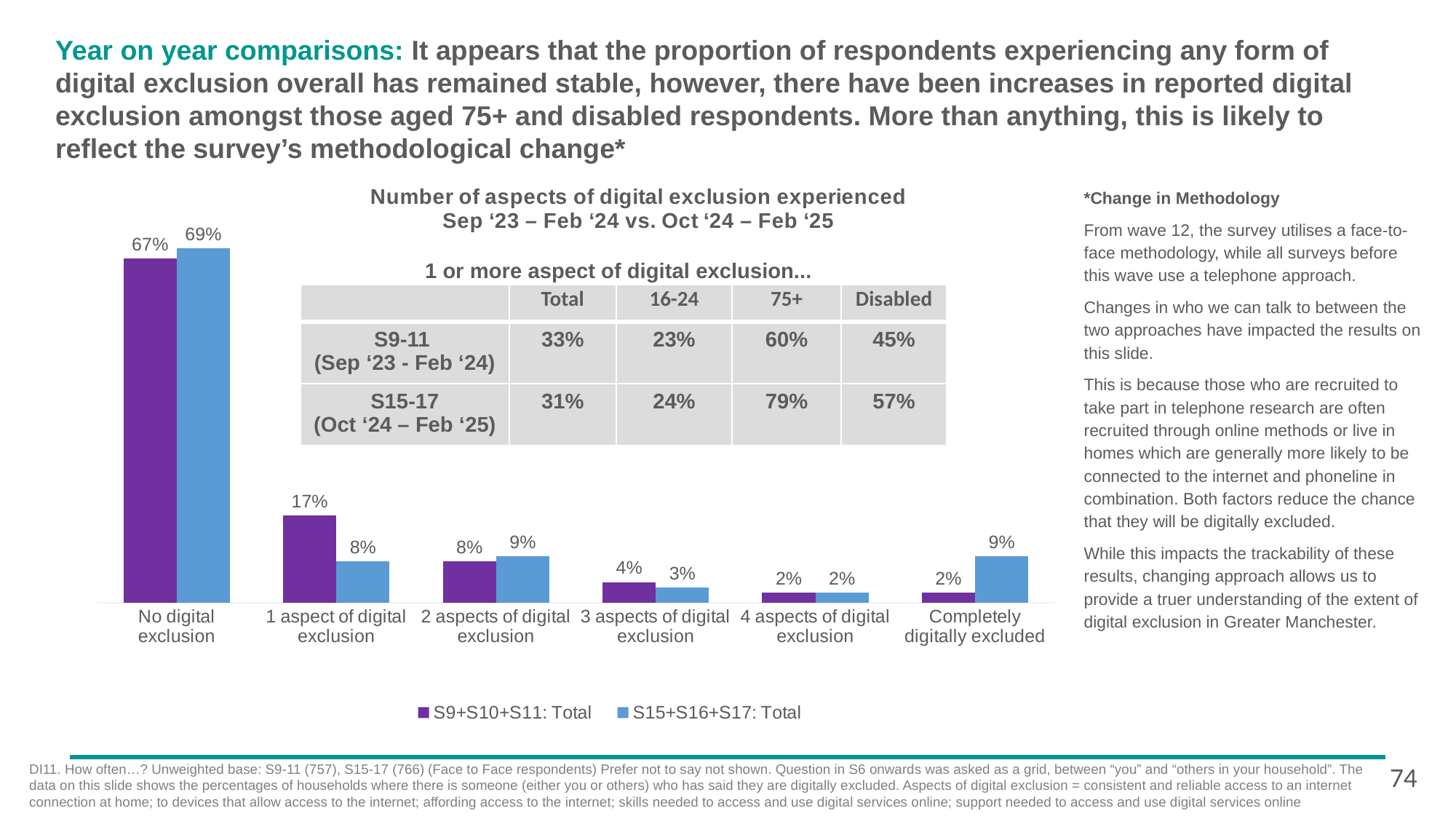
How many series does the chart legend list? 2 What kind of chart is shown on the slide? Bar chart What is the difference between the S15+S16+S17: Total and S9+S10+S11: Total values for 'No digital exclusion'? 2% For 'Completely digitally excluded', which series has the larger value: S9+S10+S11: Total or S15+S16+S17: Total? S15+S16+S17: Total What is the value for '3 aspects of digital exclusion' in the S15+S16+S17: Total series? 3% What is the value for '1 aspect of digital exclusion' in the S9+S10+S11: Total series? 17% What is the difference between the S9+S10+S11: Total and S15+S16+S17: Total values for '1 aspect of digital exclusion'? 9% Which category has the highest value in the S9+S10+S11: Total series? No digital exclusion How many categories are shown on the x axis of the chart? 6 What is the title of the chart? Number of aspects of digital exclusion experienced Sep '23 – Feb '24 vs. Oct '24 – Feb '25 What is the value for 'Completely digitally excluded' in the S15+S16+S17: Total series? 9% What is the value for 'No digital exclusion' in the S15+S16+S17: Total series? 69%